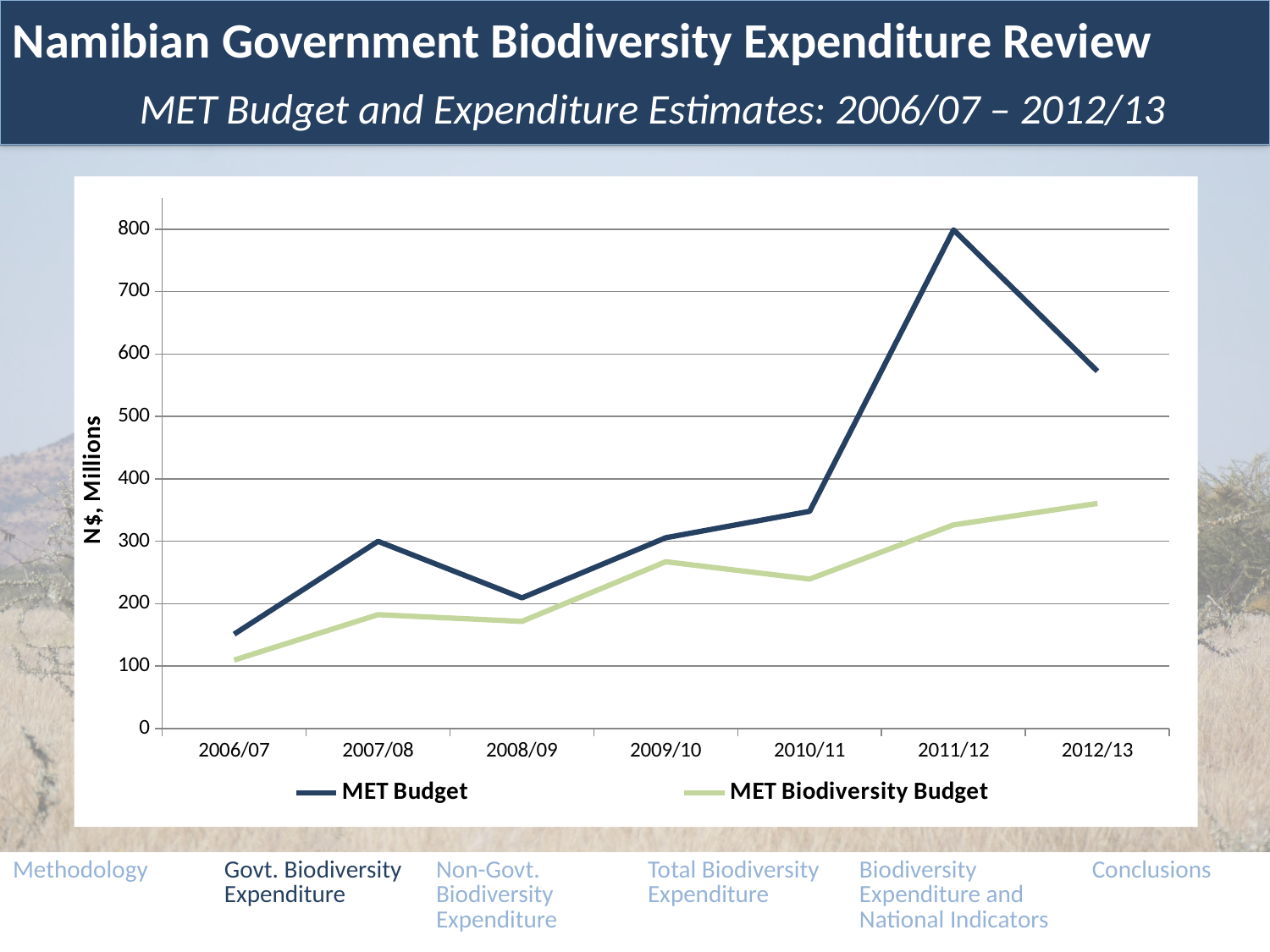
In 2010/11, which is larger: the MET Budget or the MET Biodiversity Budget? MET Budget In which year is the MET Biodiversity Budget lowest? 2006/07 In which year is the MET Budget lowest? 2006/07 What kind of chart is shown on the slide? line chart How many fiscal years are plotted along the x axis? 7 Does the MET Budget rise or fall from 2011/12 to 2012/13? fall Is the MET Biodiversity Budget value for 2006/07 greater or less than 200? less In which year is the MET Biodiversity Budget highest? 2012/13 In which year is the MET Budget highest? 2011/12 What is the label on the y axis? N$, Millions Is the MET Budget value for 2011/12 greater or less than 700? greater How many series does the legend list? 2